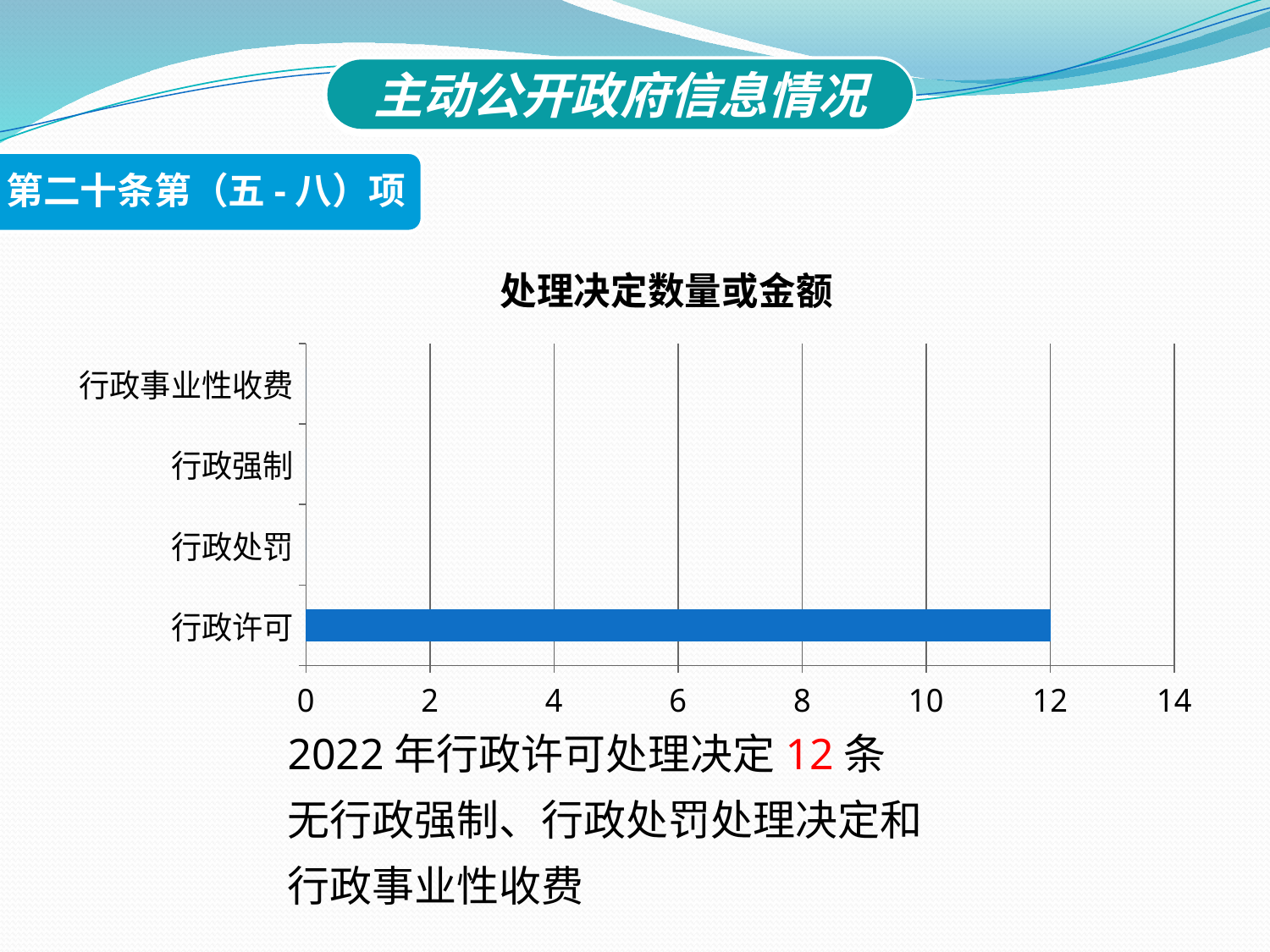
Is the value for 行政许可 greater or less than 14? less Which is larger, the value for 行政许可 or the value for 行政处罚? 行政许可 What type of chart is shown on the slide? bar chart How many categories have a visible bar on the chart? 1 Is the value for 行政许可 greater or less than 10? greater How many categories are listed on the chart's vertical axis? 4 Which category has the highest value? 行政许可 What is the value for 行政许可? 12 What is the title of the chart? 处理决定数量或金额 What is the value for 行政强制? 0 What is the maximum value shown on the horizontal axis? 14